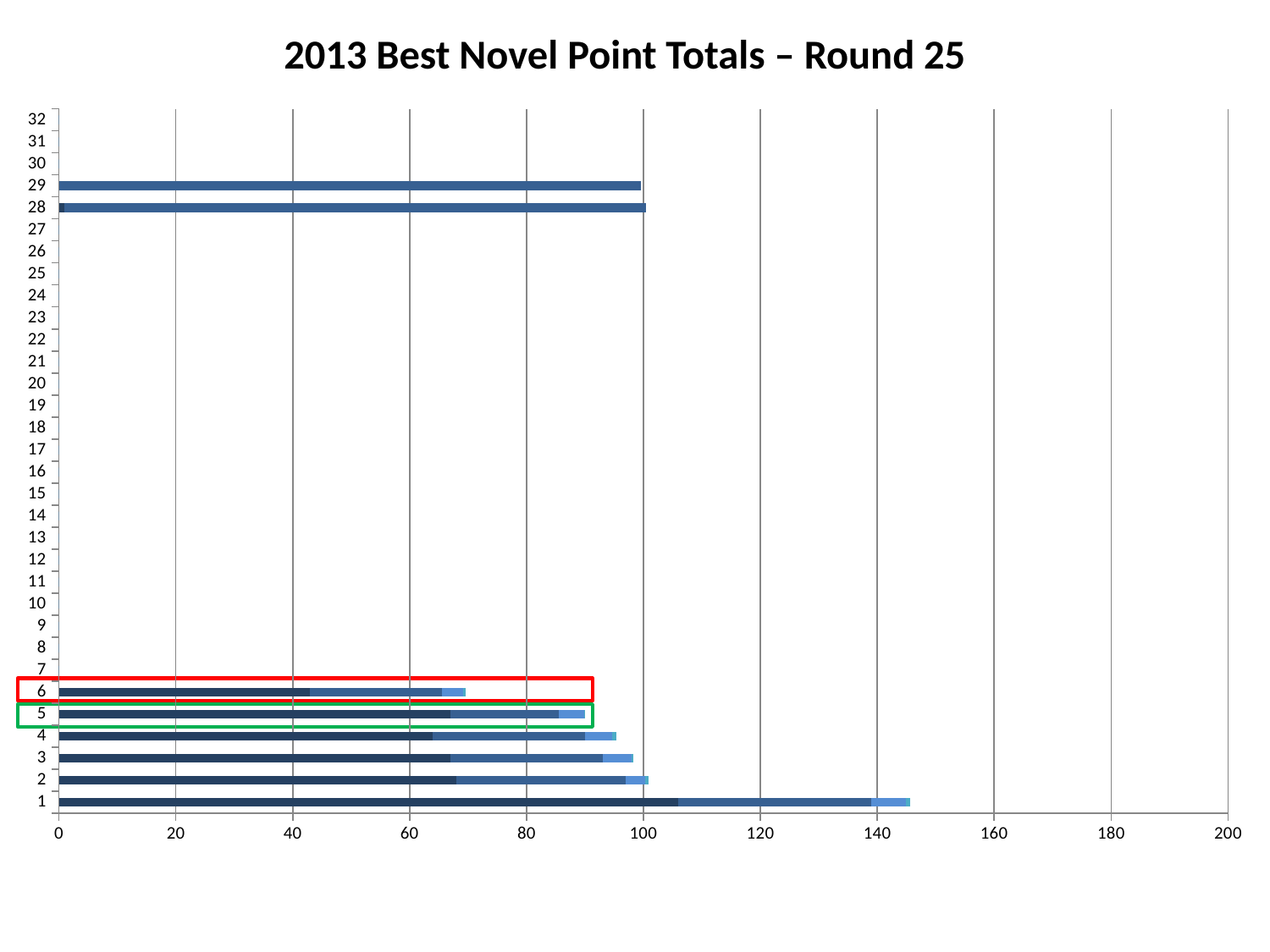
Is the total value for category 1 greater or less than 120? greater Is the value for category 29 greater or less than 120? less Among the categories that have a bar drawn, which one has the shortest bar? 6 Is the total value for category 5 greater or less than 100? less What kind of chart is shown on the slide? bar chart Which category has the longest bar in the chart? 1 Which has the larger total value, category 4 or category 6? category 4 How many categories are listed on the vertical axis of the chart? 32 What is the title of the chart? 2013 Best Novel Point Totals – Round 25 Which category's bar is outlined with a red box on the chart? 6